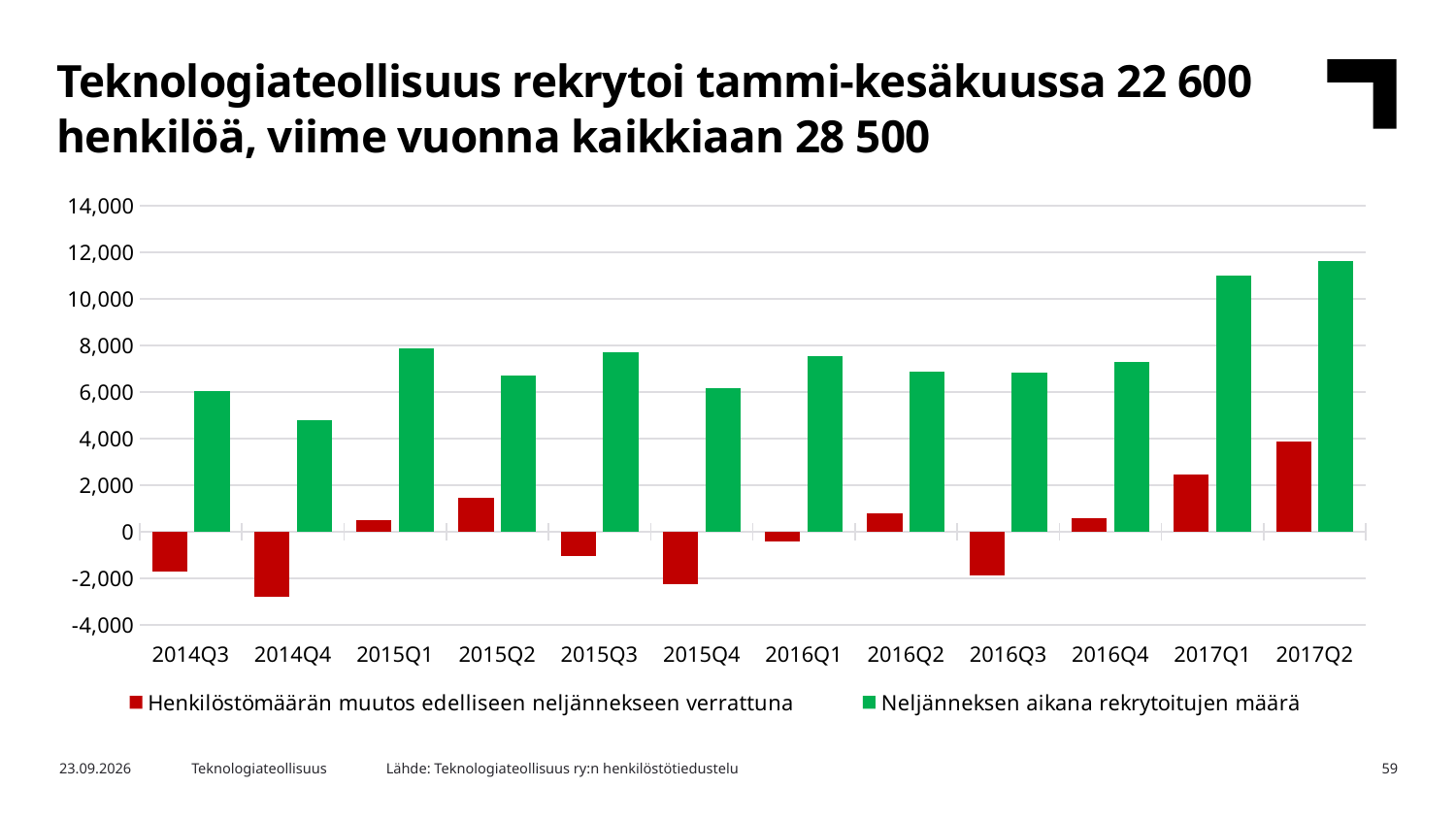
Which colour represents 'Neljänneksen aikana rekrytoitujen määrä' in the chart? green Which quarter has the lowest value for 'Neljänneksen aikana rekrytoitujen määrä'? 2014Q4 How many quarters are shown on the x axis? 12 Which is larger, the 'Neljänneksen aikana rekrytoitujen määrä' value for 2015Q1 or for 2015Q4? 2015Q1 Which quarter has the highest value for 'Neljänneksen aikana rekrytoitujen määrä'? 2017Q2 Which quarter has the lowest value for 'Henkilöstömäärän muutos edelliseen neljännekseen verrattuna'? 2014Q4 Is the value for 'Neljänneksen aikana rekrytoitujen määrä' in 2014Q4 greater or less than 6,000? less Is the value for 'Henkilöstömäärän muutos edelliseen neljännekseen verrattuna' in 2014Q4 greater or less than -2,000? less Which quarter has the highest value for 'Henkilöstömäärän muutos edelliseen neljännekseen verrattuna'? 2017Q2 Is the value for 'Neljänneksen aikana rekrytoitujen määrä' in 2017Q1 greater or less than 10,000? greater How many series does the legend list? 2 What kind of chart is shown on the slide? bar chart